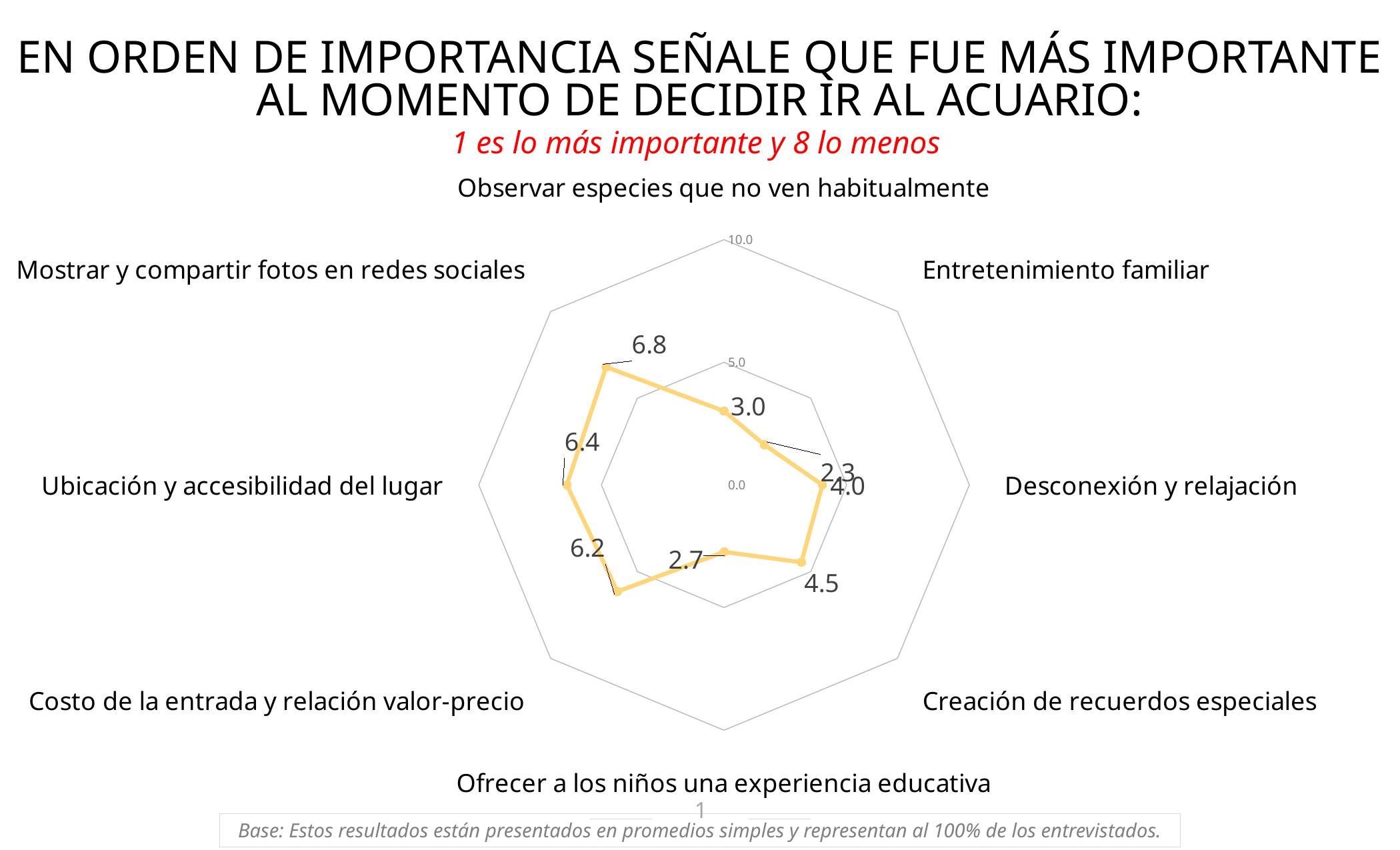
What is the value for Observar especies que no ven habitualmente? 3.0 How many categories are plotted on the chart? 8 Which category has the highest value? Mostrar y compartir fotos en redes sociales What is the value for Creación de recuerdos especiales? 4.5 What is the value for Ofrecer a los niños una experiencia educativa? 2.7 What is the maximum value shown on the chart's axis scale? 10.0 What is the difference between the values for Mostrar y compartir fotos en redes sociales and Entretenimiento familiar? 4.5 What is the value for Entretenimiento familiar? 2.3 Which has a larger value, Desconexión y relajación or Costo de la entrada y relación valor-precio? Costo de la entrada y relación valor-precio Which category has the lowest value? Entretenimiento familiar What kind of chart is shown on the slide? Radar chart What is the value for Ubicación y accesibilidad del lugar? 6.4